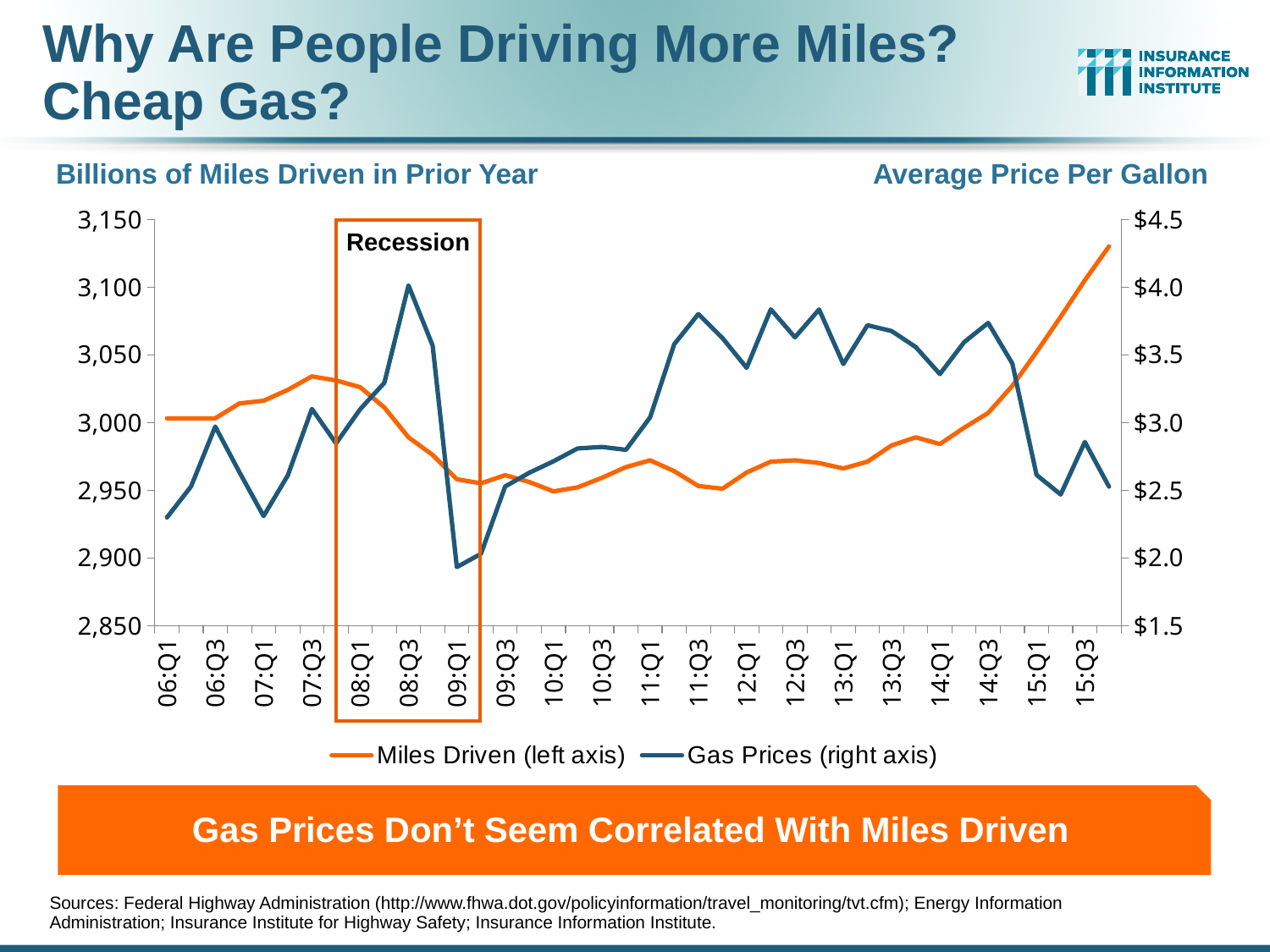
At which quarter does the Gas Prices series reach its lowest value? 09:Q1 What kind of chart is shown on the slide? Line chart How many series does the legend list? 2 What is the title of the left axis? Billions of Miles Driven in Prior Year Is the Gas Prices value at 06:Q1 greater or less than $2.5? less Does the Miles Driven series rise or fall from 14:Q1 to 15:Q3? rise At which quarter does the Miles Driven series reach its highest value? 15:Q4 Which series is plotted against the right axis according to the legend? Gas Prices Is the Gas Prices value at 08:Q3 greater or less than $3.5? greater Is the Gas Prices value at 09:Q1 greater or less than $2.5? less